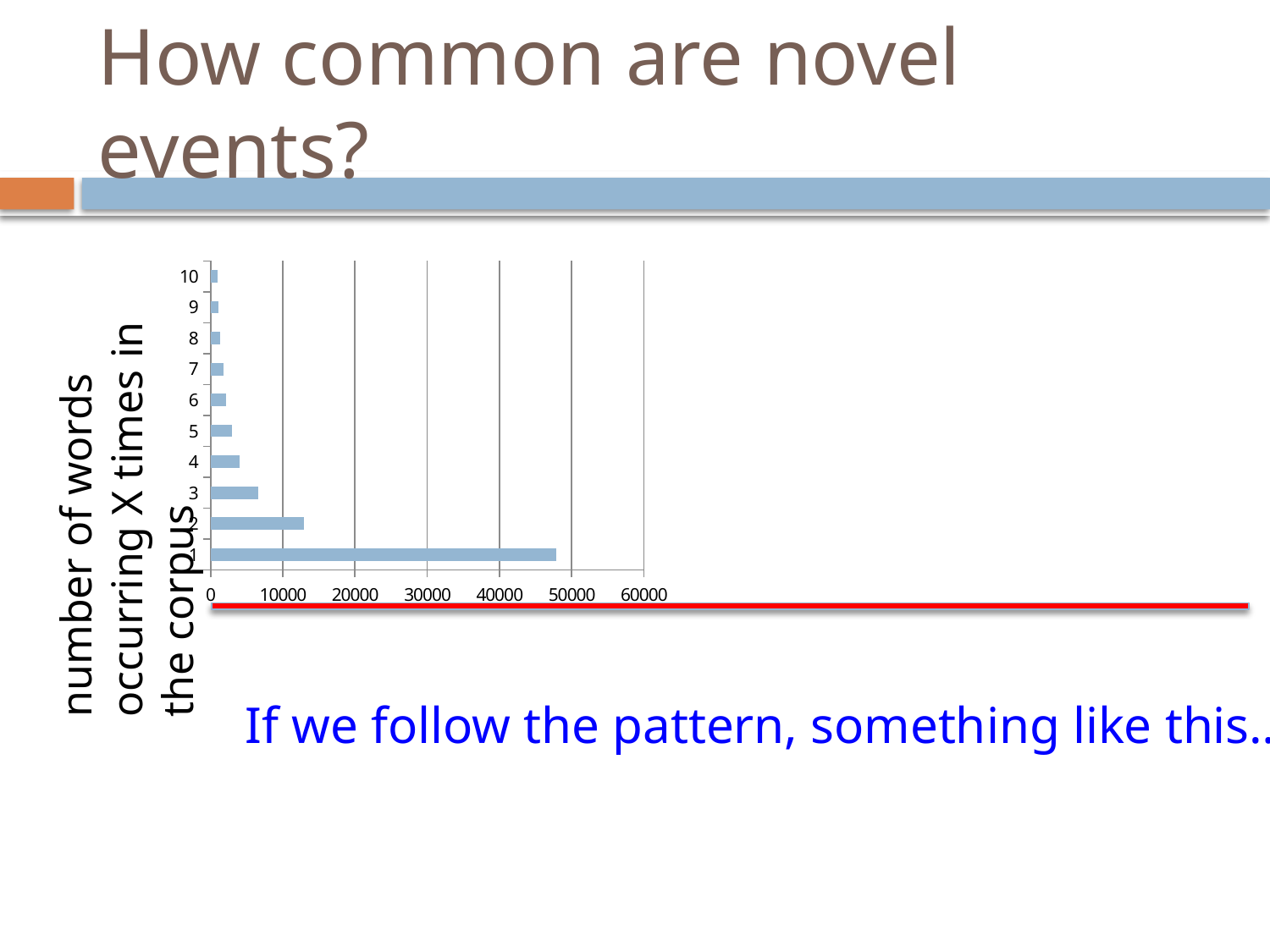
Which is larger, the value for category 1 or the value for category 2? 1 Which category has the longest bar? 1 Which is larger, the value for category 3 or the value for category 4? 3 Is the value for category 2 greater or less than 10000? greater Is the value for category 3 greater or less than 10000? less Is the value for category 2 greater or less than 20000? less What kind of chart is shown on the slide? bar chart How many categories (bars) are plotted on the chart? 10 Do the bar values rise or fall as the category number increases from 1 to 10? fall What is the highest tick value shown on the horizontal axis? 60000